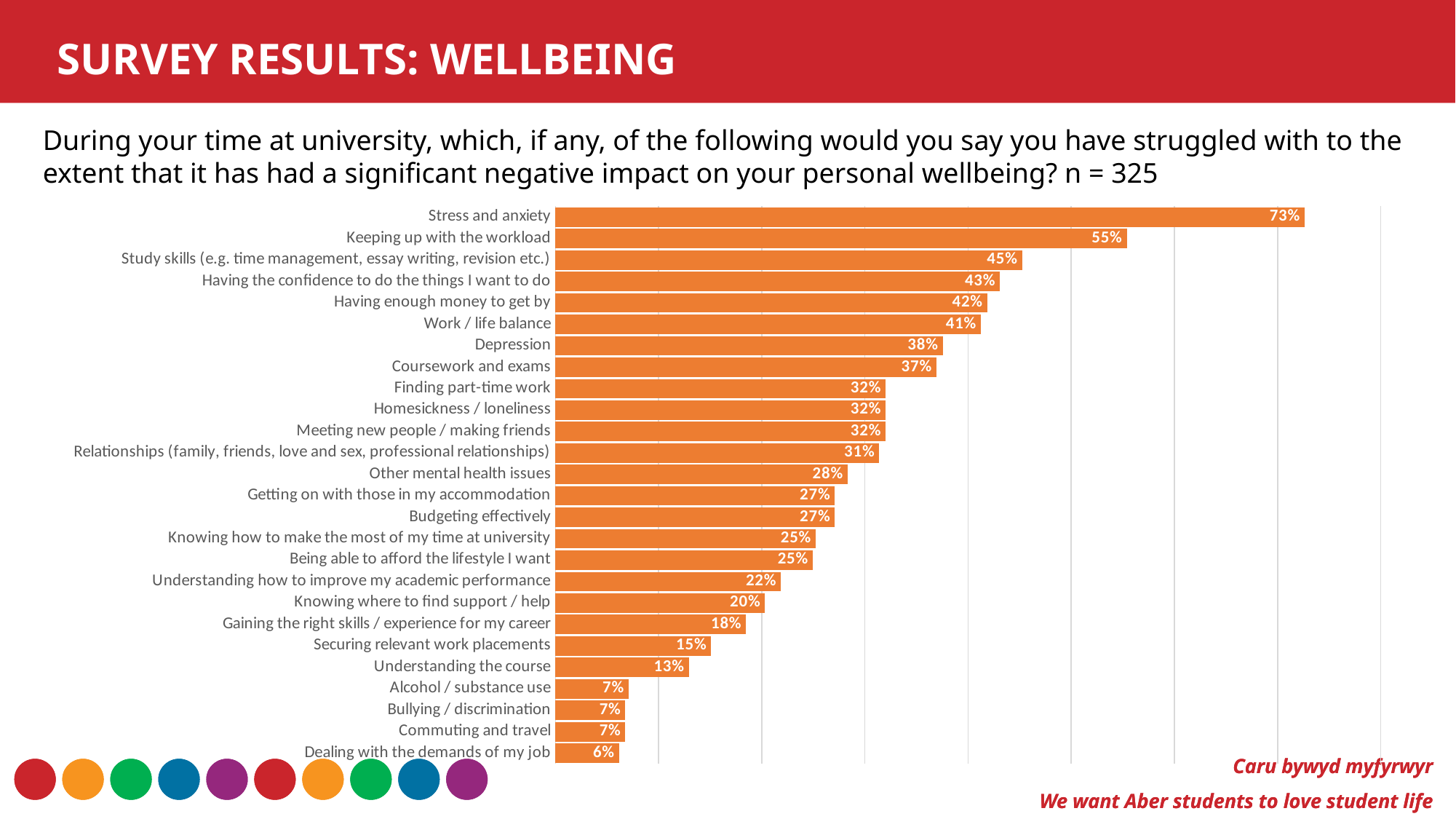
What is the sample size (n) stated in the survey question above the chart? 325 How many categories are shown in the chart? 26 What is the difference in percentage points between Having enough money to get by and Budgeting effectively? 15 What percentage is shown for Knowing where to find support / help? 20% What colour are the bars in the chart? Orange What is the value shown for Depression? 38% What percentage of respondents said they struggled with stress and anxiety? 73% What kind of chart is shown on the slide? Bar chart Which category has the highest percentage? Stress and anxiety Which is larger: the value for Coursework and exams or the value for Finding part-time work? Coursework and exams What is the difference in percentage points between Stress and anxiety and Keeping up with the workload? 18 Which category has the lowest percentage? Dealing with the demands of my job